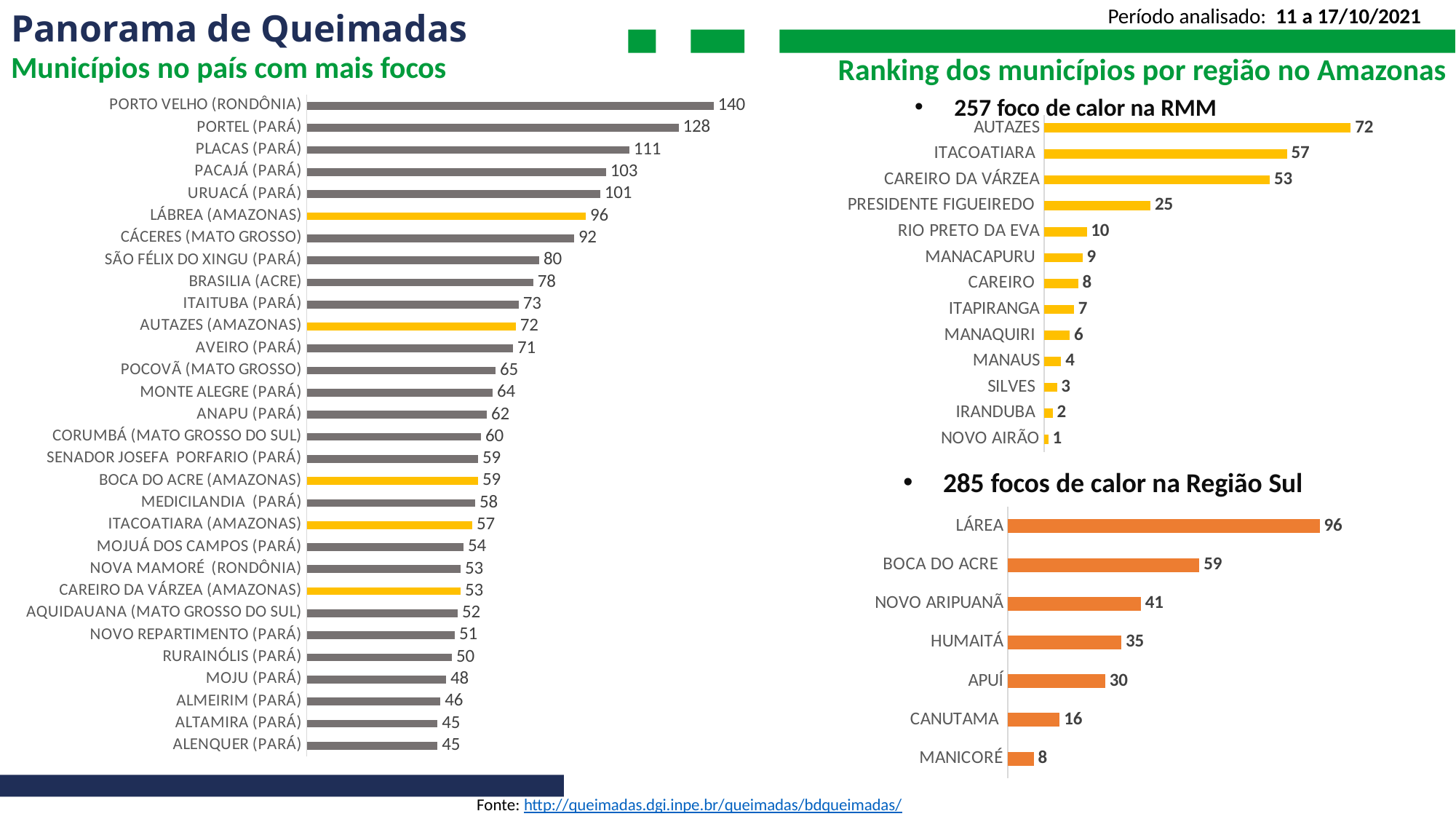
In the chart 'Municípios no país com mais focos', how many municipalities are listed? 30 In the chart 'Municípios no país com mais focos', which is larger: CÁCERES (MATO GROSSO) or LÁBREA (AMAZONAS)? LÁBREA (AMAZONAS) In the chart 'Municípios no país com mais focos', what is the value for PORTO VELHO (RONDÔNIA)? 140 In the chart 'Municípios no país com mais focos', which municipality has the lowest value? ALENQUER (PARÁ) and ALTAMIRA (PARÁ), both 45 In the chart '257 foco de calor na RMM', how many municipalities are shown? 13 What type of chart is '285 focos de calor na Região Sul'? Bar chart In the chart '257 foco de calor na RMM', which municipality has the highest value? AUTAZES In the chart '285 focos de calor na Região Sul', what is the value for HUMAITÁ? 35 In the chart '285 focos de calor na Região Sul', which municipality has the lowest value? MANICORÉ In the chart '285 focos de calor na Região Sul', what is the difference between LÁREA and BOCA DO ACRE? 37 In the chart '257 foco de calor na RMM', what is the value for PRESIDENTE FIGUEIREDO? 25 In the chart 'Municípios no país com mais focos', what is the difference between PORTEL (PARÁ) and PLACAS (PARÁ)? 17